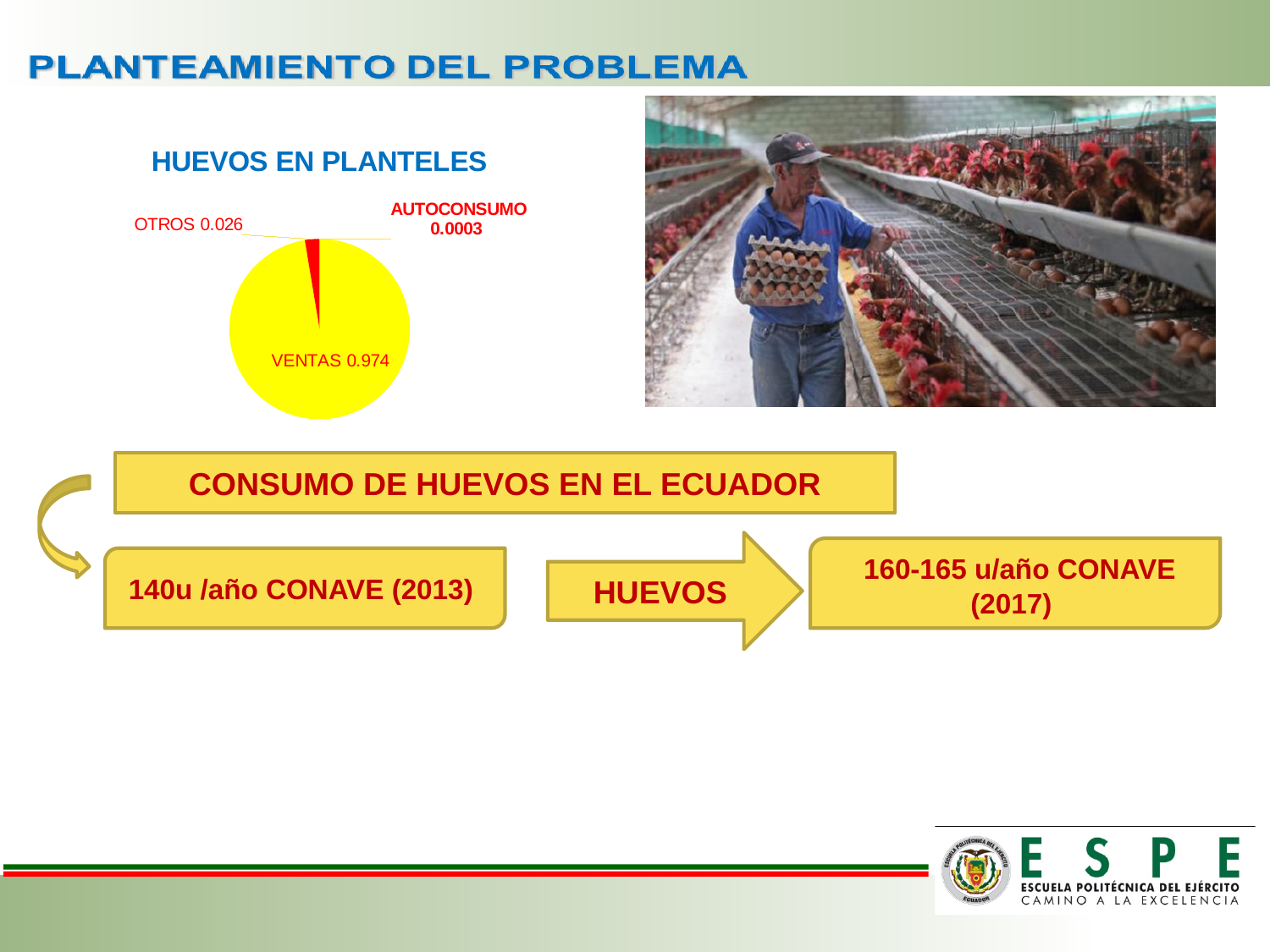
What is the difference between the values for VENTAS and OTROS? 0.948 Which category has the largest slice in the pie chart? VENTAS What is the title of the chart? HUEVOS EN PLANTELES What kind of chart is shown on the slide? Pie chart Which category has the smallest slice in the pie chart? AUTOCONSUMO What colour is the VENTAS slice in the pie chart? Yellow What is the value shown for VENTAS in the pie chart? 0.974 What is the value shown for OTROS in the pie chart? 0.026 What is the value shown for AUTOCONSUMO in the pie chart? 0.0003 How many categories are shown in the pie chart? 3 Which is larger, the value for OTROS or the value for AUTOCONSUMO? OTROS